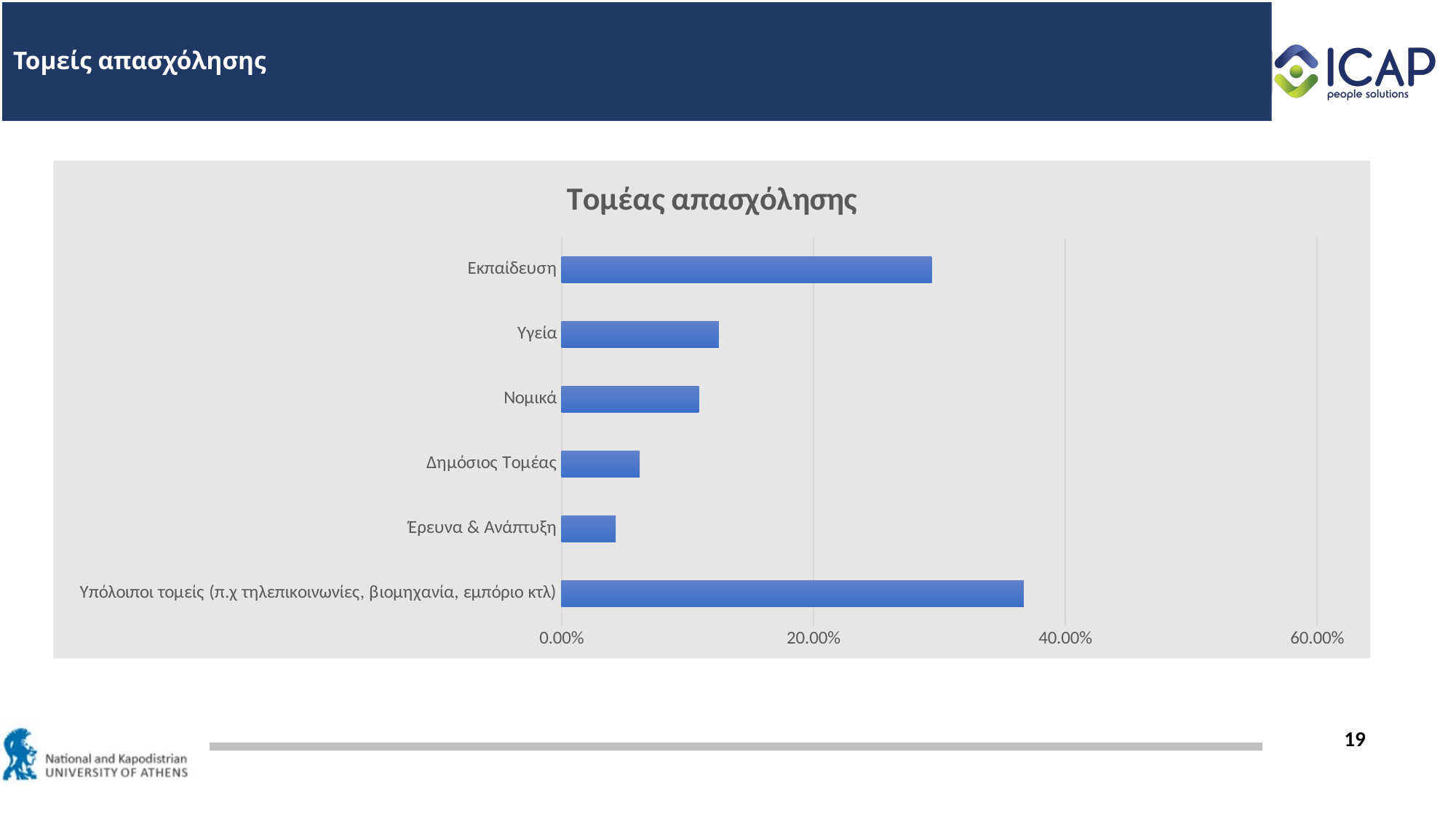
Is the value for Έρευνα & Ανάπτυξη greater or less than 20.00%? less Which is larger, the value for Εκπαίδευση or the value for Υγεία? Εκπαίδευση Is the value for Υπόλοιποι τομείς (π.χ τηλεπικοινωνίες, βιομηχανία, εμπόριο κτλ) greater or less than 40.00%? less How many categories are plotted in the chart? 6 Which is larger, the value for Νομικά or the value for Δημόσιος Τομέας? Νομικά Is the value for Υγεία greater or less than 20.00%? less What kind of chart is shown on the slide? Bar chart Which category has the lowest value in the chart? Έρευνα & Ανάπτυξη What is the highest value shown on the horizontal axis of the chart? 60.00% What is the title of the chart? Τομέας απασχόλησης Which category has the highest value in the chart? Υπόλοιποι τομείς (π.χ τηλεπικοινωνίες, βιομηχανία, εμπόριο κτλ)